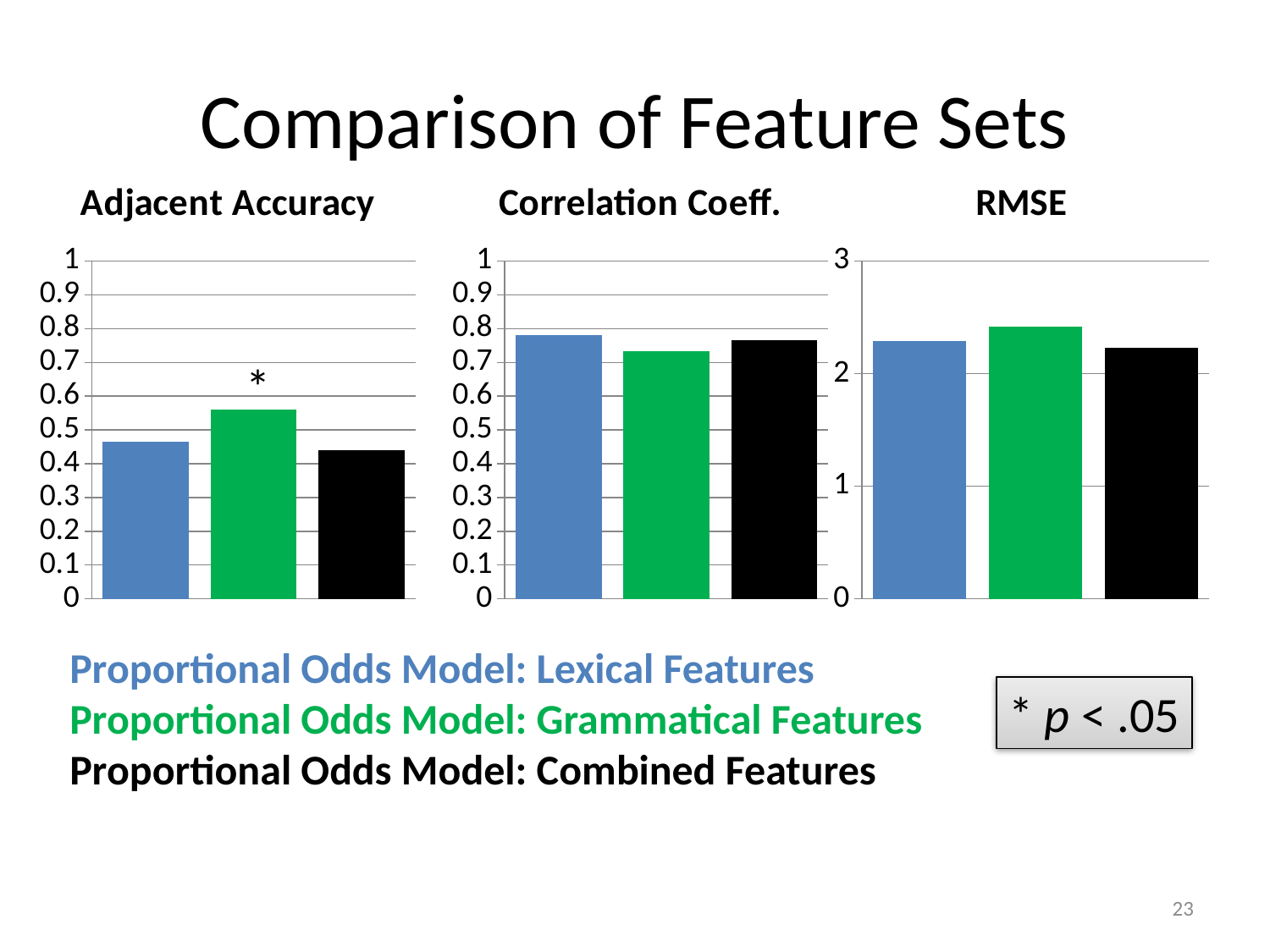
In the Correlation Coeff. chart, is the value for Grammatical Features greater or less than 0.8? less In the Adjacent Accuracy chart, is the value for Grammatical Features greater or less than 0.5? greater In the Adjacent Accuracy chart, which feature set has the highest bar? Grammatical Features In the Correlation Coeff. chart, is the value for Lexical Features greater or less than 0.7? greater In the Correlation Coeff. chart, which feature set has the lowest bar? Grammatical Features How many bars are shown in the RMSE chart? 3 In the Adjacent Accuracy chart, which bar is marked with an asterisk? Grammatical Features In the RMSE chart, which feature set has the highest bar? Grammatical Features What kind of chart is the Adjacent Accuracy chart? bar chart